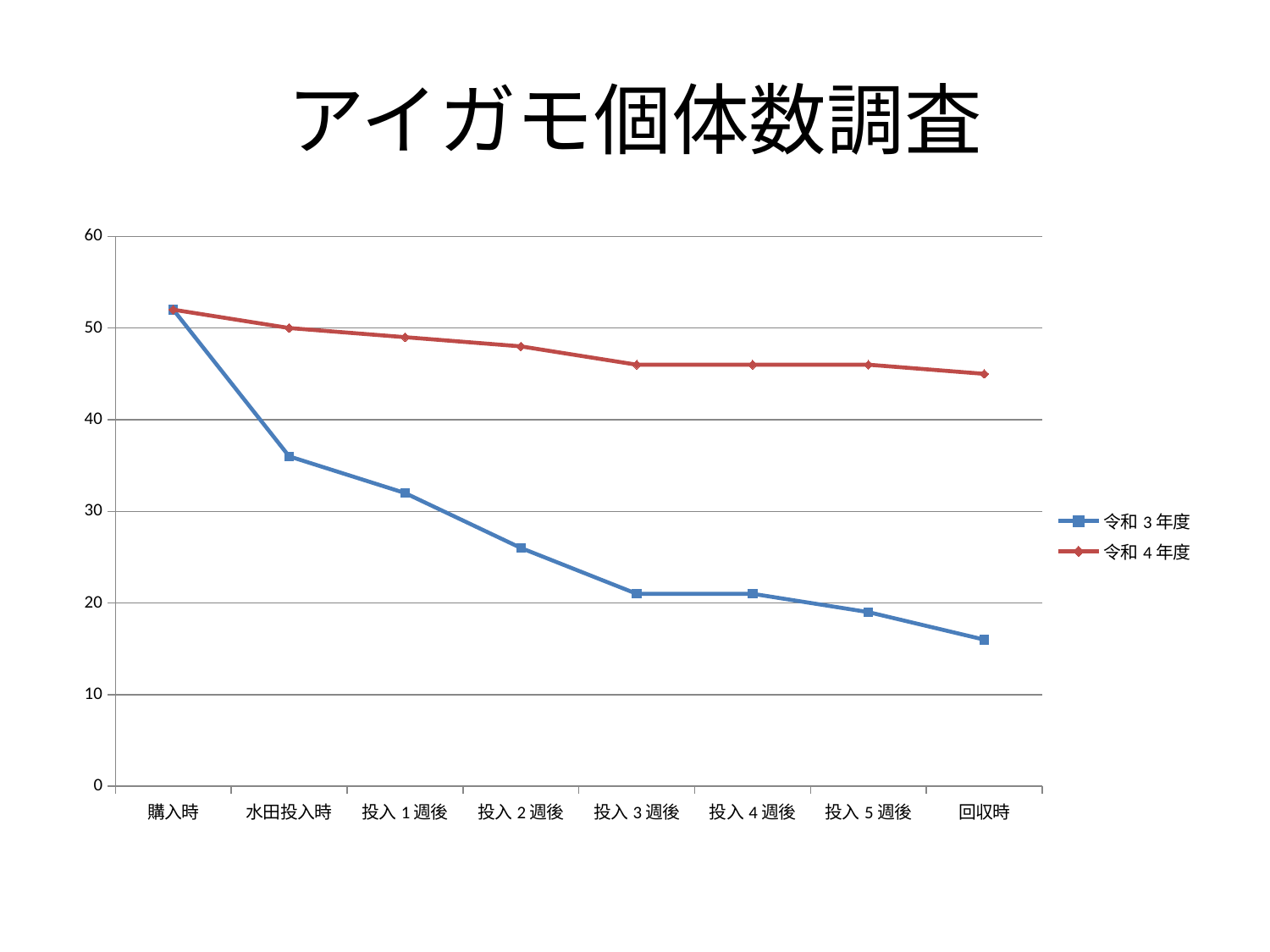
At which category is the 令和3年度 series lowest? 回収時 Do the values for 令和3年度 rise or fall from 購入時 to 回収時? fall Is the value for 令和4年度 at 回収時 greater or less than 40? greater How many series does the legend list? 2 What kind of chart is shown on the slide? line chart At which category is the 令和3年度 series highest? 購入時 What is the title of the chart? アイガモ個体数調査 Is the value for 令和3年度 at 水田投入時 greater or less than 30? greater Which series is drawn in blue? 令和3年度 Is the value for 令和3年度 at 回収時 greater or less than 20? less At 回収時, which series has the larger value, 令和3年度 or 令和4年度? 令和4年度 How many categories are shown on the x axis? 8